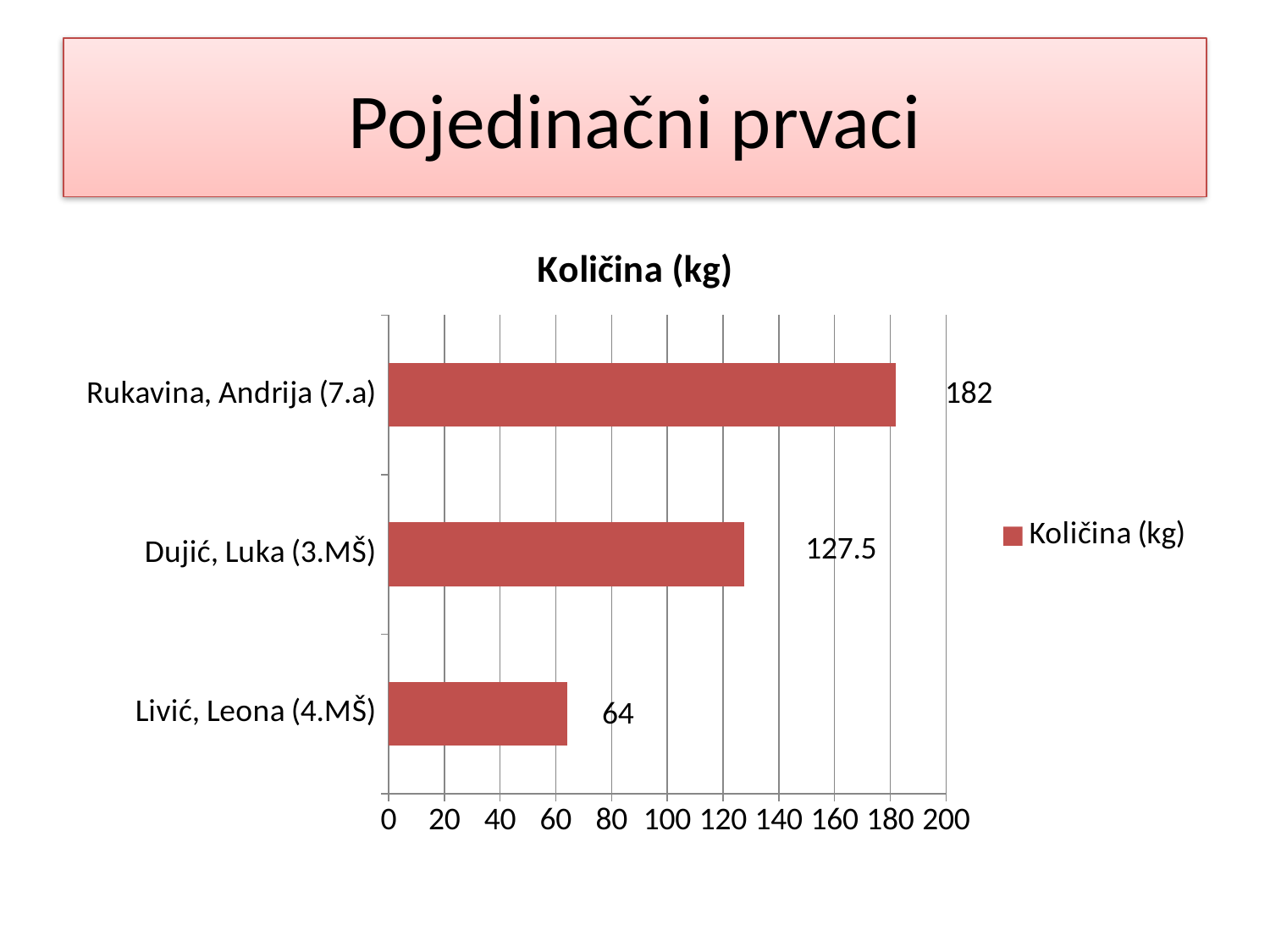
What is the value for Rukavina, Andrija (7.a)? 182 What is the difference between the values for Dujić, Luka (3.MŠ) and Livić, Leona (4.MŠ)? 63.5 Which category has the lowest value? Livić, Leona (4.MŠ) What kind of chart is shown on the slide? bar chart What is the title of the chart? Količina (kg) How many categories are shown in the chart? 3 Is the value for Rukavina, Andrija (7.a) greater or less than 160? greater What is the value for Dujić, Luka (3.MŠ)? 127.5 Which category has the highest value? Rukavina, Andrija (7.a) What is the difference between the values for Rukavina, Andrija (7.a) and Dujić, Luka (3.MŠ)? 54.5 Which is larger, the value for Dujić, Luka (3.MŠ) or the value for Livić, Leona (4.MŠ)? Dujić, Luka (3.MŠ) What is the value for Livić, Leona (4.MŠ)? 64